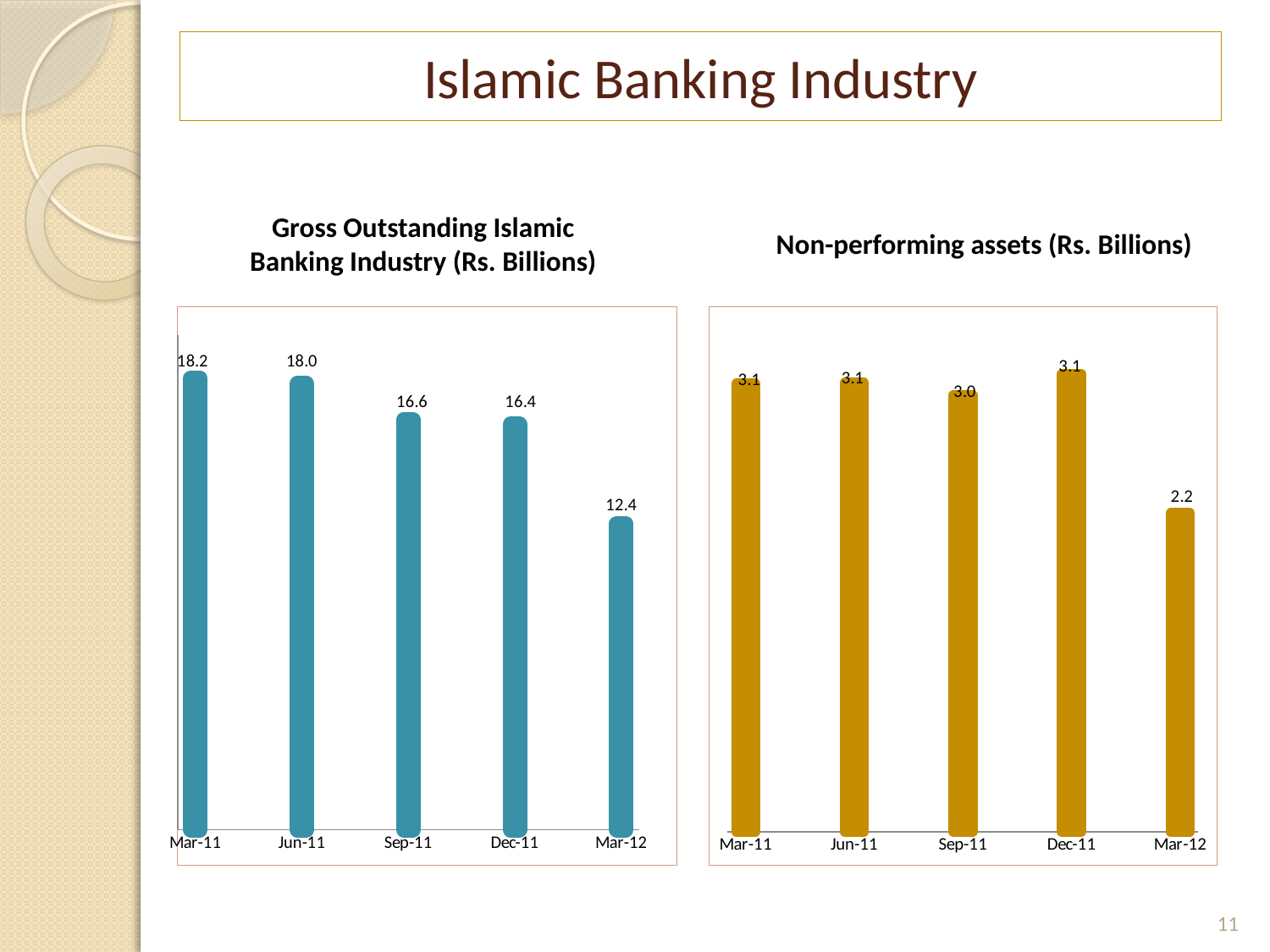
In the 'Gross Outstanding Islamic Banking Industry (Rs. Billions)' chart, which period has the lowest value? Mar-12 In the 'Gross Outstanding Islamic Banking Industry (Rs. Billions)' chart, do the values rise or fall from Mar-11 to Mar-12? fall What type of chart is the 'Gross Outstanding Islamic Banking Industry (Rs. Billions)' chart? bar chart In the 'Non-performing assets (Rs. Billions)' chart, which period has the lowest value? Mar-12 In the 'Gross Outstanding Islamic Banking Industry (Rs. Billions)' chart, what is the difference between the Jun-11 and Sep-11 values? 1.4 In the 'Non-performing assets (Rs. Billions)' chart, what is the difference between the Dec-11 and Mar-12 values? 0.9 In the 'Non-performing assets (Rs. Billions)' chart, what is the value for Mar-12? 2.2 In the 'Gross Outstanding Islamic Banking Industry (Rs. Billions)' chart, what is the value for Mar-11? 18.2 In the 'Gross Outstanding Islamic Banking Industry (Rs. Billions)' chart, what is the value for Mar-12? 12.4 In the 'Non-performing assets (Rs. Billions)' chart, what is the value for Sep-11? 3.0 How many periods are shown on the x axis of the 'Non-performing assets (Rs. Billions)' chart? 5 In the 'Gross Outstanding Islamic Banking Industry (Rs. Billions)' chart, which period has the highest value? Mar-11